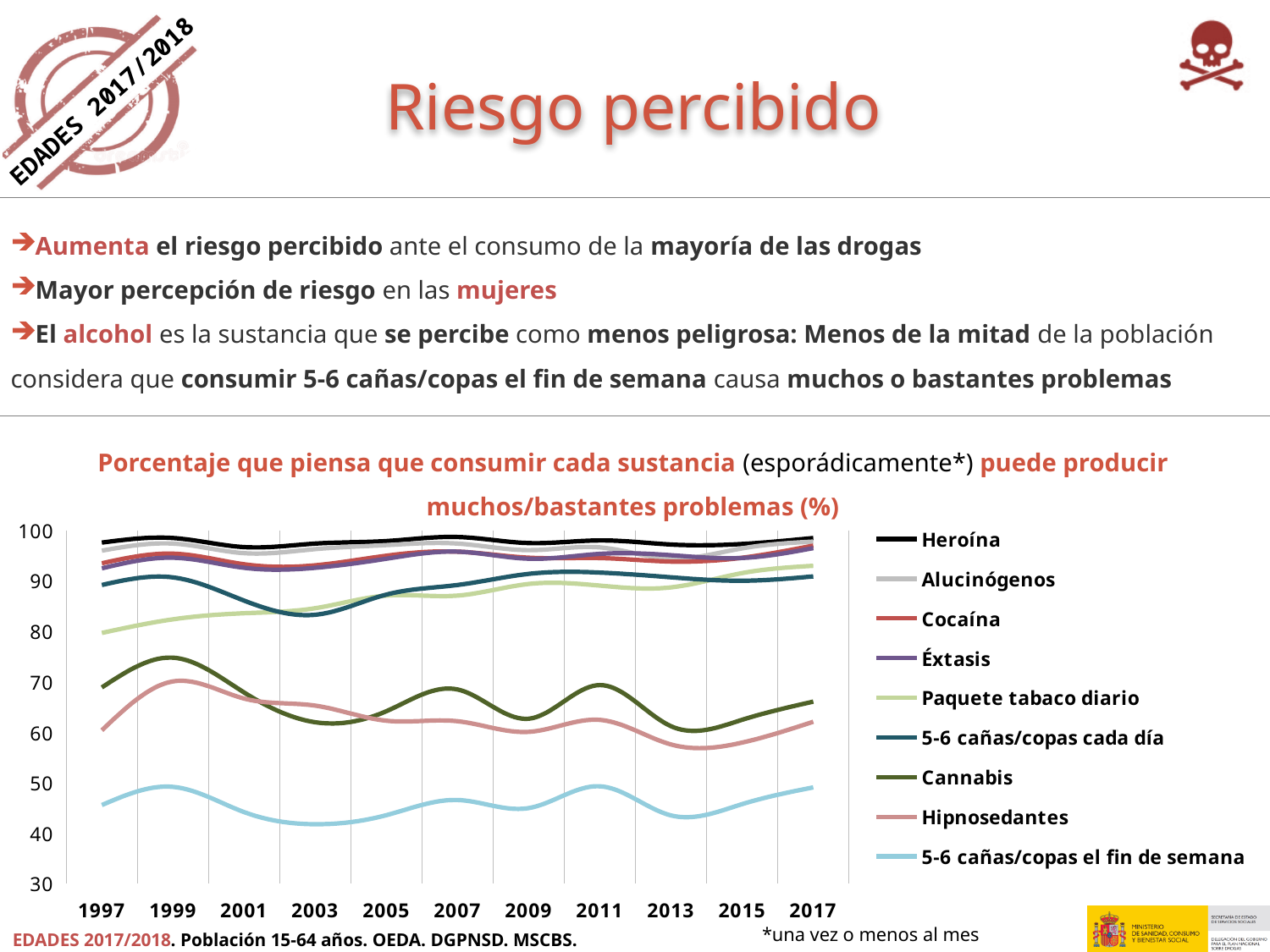
What colour is the line for Heroína in the chart? black Is the value for Heroína in 2017 greater or less than 90? greater Is the value for Paquete tabaco diario in 1997 greater or less than 70? greater Is the value for 5-6 cañas/copas el fin de semana in 2003 greater or less than 50? less How many series does the legend of the chart list? 9 How many years are labelled on the x axis of the chart? 11 Which substance has the lowest perceived-risk line across the whole chart? 5-6 cañas/copas el fin de semana What kind of chart is shown on the slide? line chart In 2017, which is larger: the value for Heroína or the value for Cannabis? Heroína Which substance has the highest perceived-risk line across the whole chart? Heroína Does the line for Paquete tabaco diario rise or fall overall from 1997 to 2017? rise